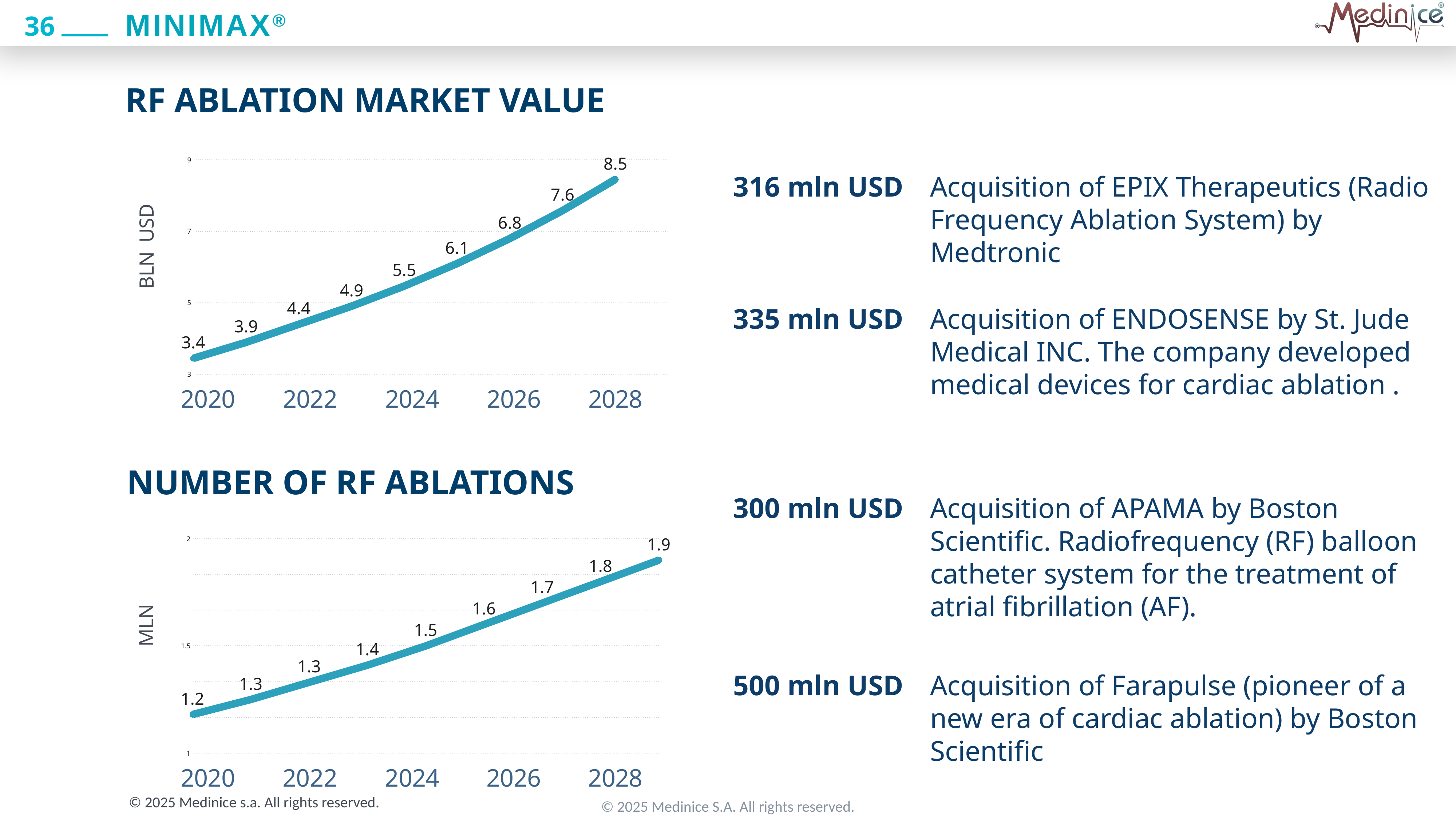
In the Number of RF Ablations chart, what is the value for 2028? 1.9 In the RF Ablation Market Value chart, what is the value for 2028? 8.5 In the RF Ablation Market Value chart, how many data points are plotted? 9 In the RF Ablation Market Value chart, what is the value for 2024? 5.5 In the RF Ablation Market Value chart, which year has the highest value? 2028 In the Number of RF Ablations chart, which year has the lowest value? 2020 In the Number of RF Ablations chart, do the values rise or fall from 2020 to 2028? Rise What kind of chart is the RF Ablation Market Value chart? Line chart In the RF Ablation Market Value chart, what is the difference between the 2028 value and the 2020 value? 5.1 In the RF Ablation Market Value chart, what is the value for 2020? 3.4 In the Number of RF Ablations chart, what is the value for 2020? 1.2 What is the y-axis unit label on the RF Ablation Market Value chart? BLN USD